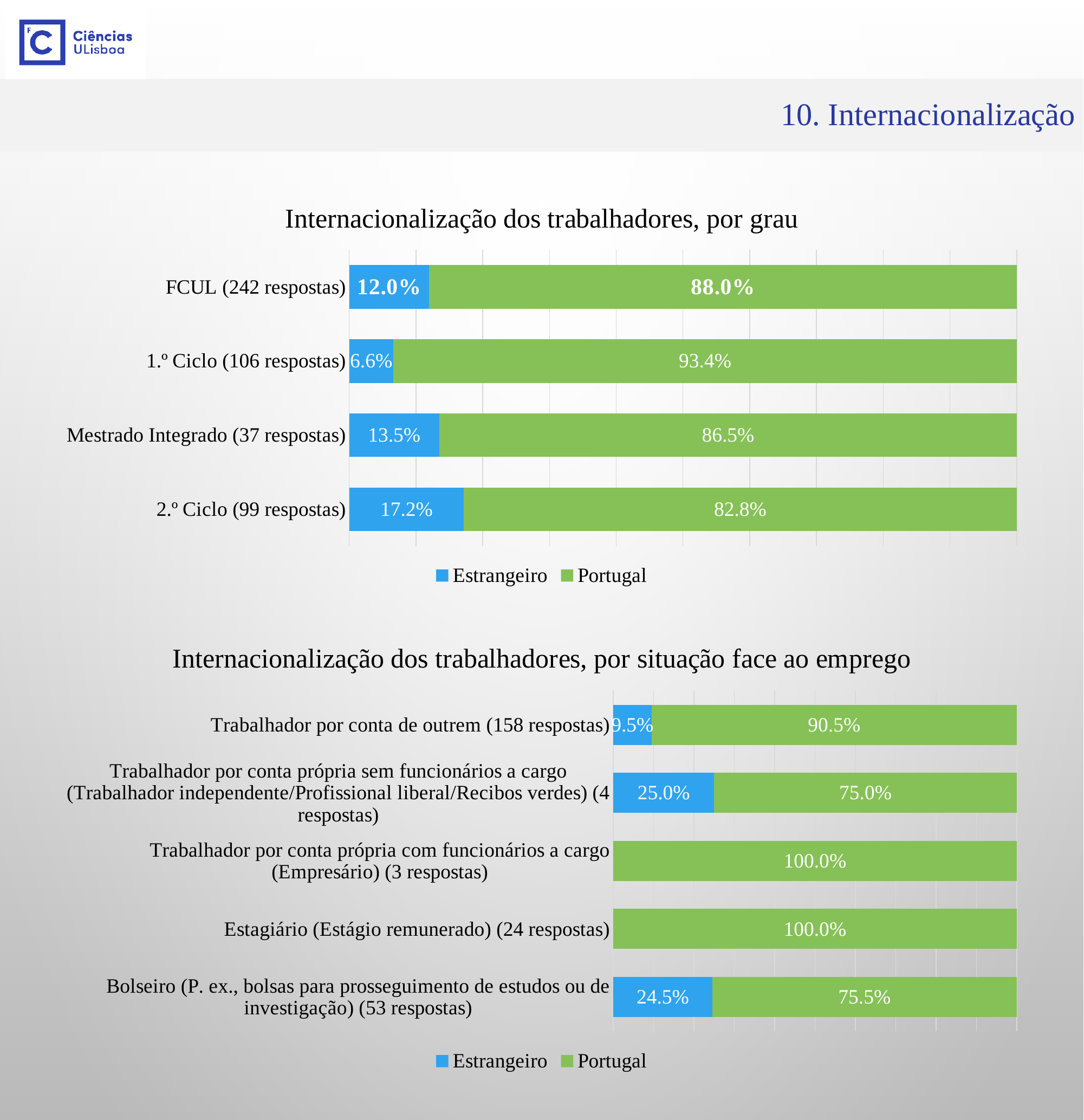
In the chart 'Internacionalização dos trabalhadores, por grau', how many categories are shown? 4 In the chart 'Internacionalização dos trabalhadores, por situação face ao emprego', what is the Portugal value for Trabalhador por conta de outrem (158 respostas)? 90.5% In the chart 'Internacionalização dos trabalhadores, por grau', what is the difference between the Estrangeiro values for 2.º Ciclo and Mestrado Integrado? 3.7% In the chart 'Internacionalização dos trabalhadores, por situação face ao emprego', what is the Estrangeiro value for Bolseiro (53 respostas)? 24.5% What type of chart is 'Internacionalização dos trabalhadores, por grau'? Stacked bar chart In the chart 'Internacionalização dos trabalhadores, por situação face ao emprego', how many series does the legend list? 2 In the chart 'Internacionalização dos trabalhadores, por situação face ao emprego', how many categories are shown? 5 In the chart 'Internacionalização dos trabalhadores, por grau', which category has the lowest Estrangeiro value? 1.º Ciclo (106 respostas) In the chart 'Internacionalização dos trabalhadores, por situação face ao emprego', which category has the highest Estrangeiro value? Trabalhador por conta própria sem funcionários a cargo (4 respostas) In the chart 'Internacionalização dos trabalhadores, por grau', which category has the highest Estrangeiro value? 2.º Ciclo (99 respostas) In the chart 'Internacionalização dos trabalhadores, por grau', what is the Portugal value for 1.º Ciclo (106 respostas)? 93.4% In the chart 'Internacionalização dos trabalhadores, por grau', what is the Estrangeiro value for FCUL (242 respostas)? 12.0%